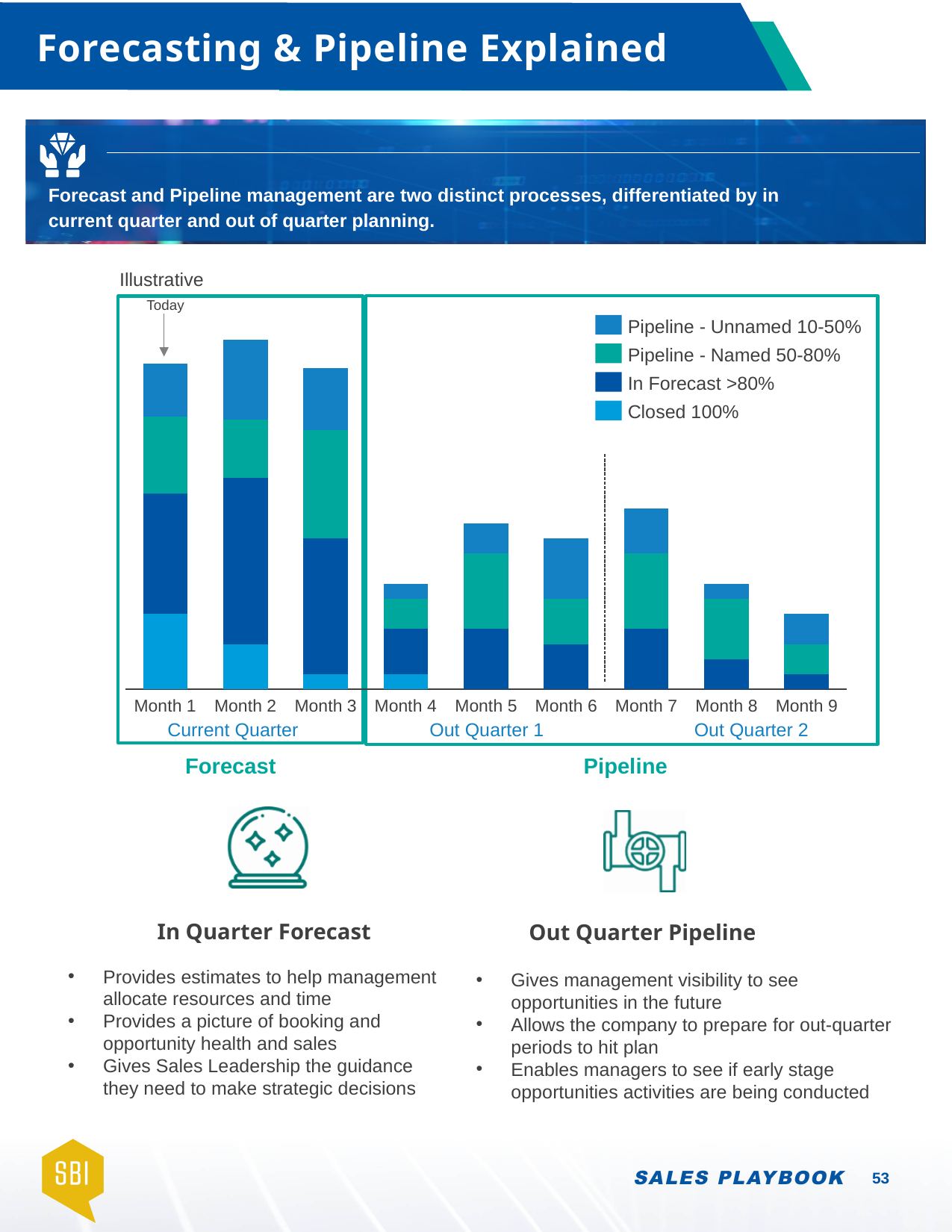
Which bar is taller overall, Month 2 or Month 4? Month 2 How many months are shown along the x axis of the chart? 9 Which months are grouped under the Out Quarter 2 label? Month 7, Month 8, Month 9 Which month has the tallest stacked bar overall? Month 2 Do the total bar heights rise or fall from Month 7 to Month 9? Fall Which months are grouped under the Current Quarter label? Month 1, Month 2, Month 3 Which month has the shortest stacked bar overall? Month 9 How many series does the chart legend list? 4 Which legend entry is shown in the darkest blue colour? In Forecast >80% Above which month's bar is the 'Today' marker placed? Month 1 Which bar is taller overall, Month 7 or Month 8? Month 7 What kind of chart is shown on the slide? Stacked bar chart